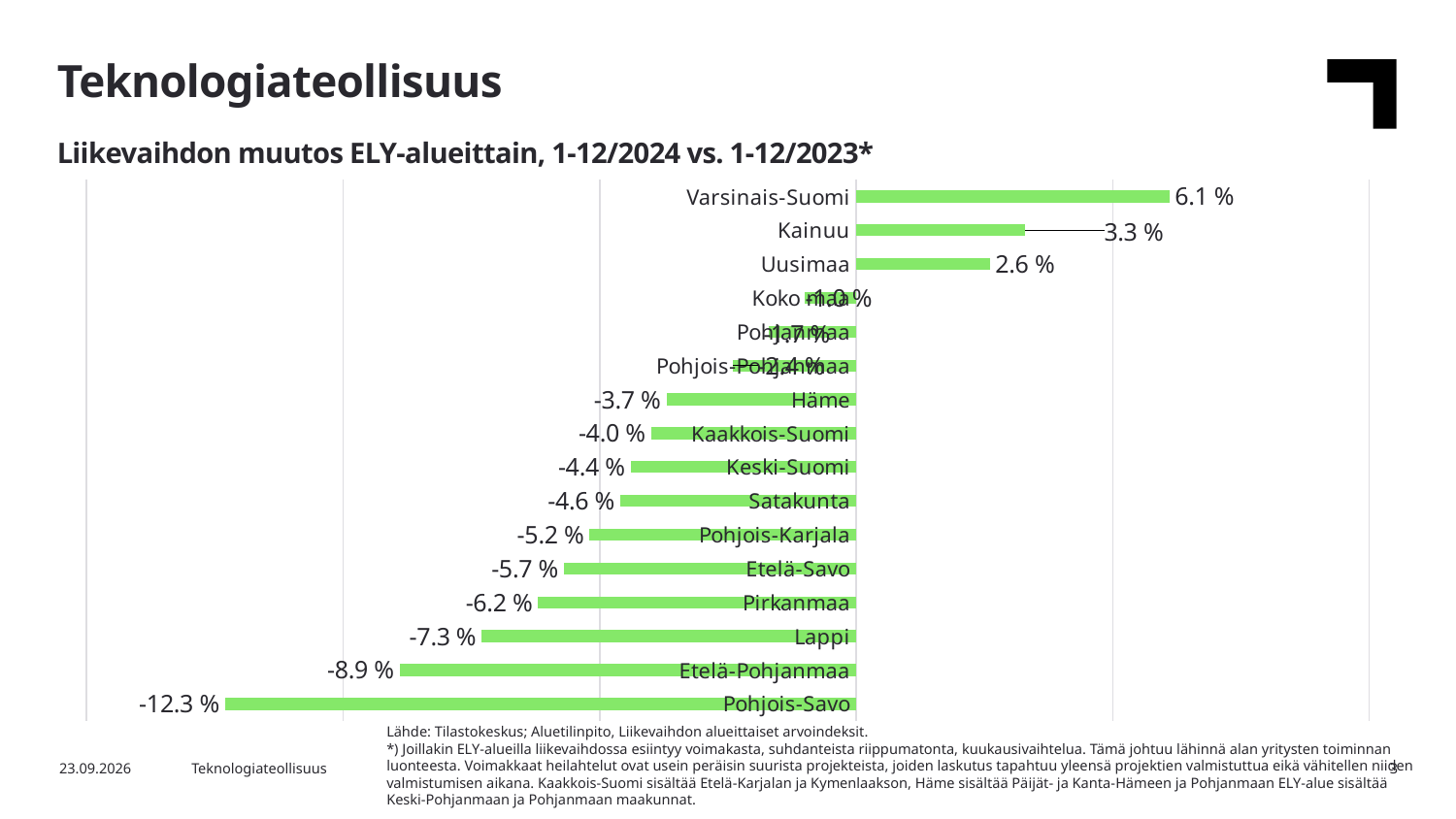
How many bars are shown in the chart? 16 What is the value for Lappi? -7.3 % What is the difference between the values for Varsinais-Suomi and Uusimaa? 3.5 % What is the subtitle of the chart? Liikevaihdon muutos ELY-alueittain, 1-12/2024 vs. 1-12/2023* Which region has the highest value? Varsinais-Suomi What is the value for Pohjois-Savo? -12.3 % Which region has the lowest value? Pohjois-Savo What is the value for Varsinais-Suomi? 6.1 % Which has the larger value, Pirkanmaa or Etelä-Savo? Etelä-Savo What is the value for Kainuu? 3.3 % What is the value for Häme? -3.7 % What kind of chart is shown on the slide? Bar chart